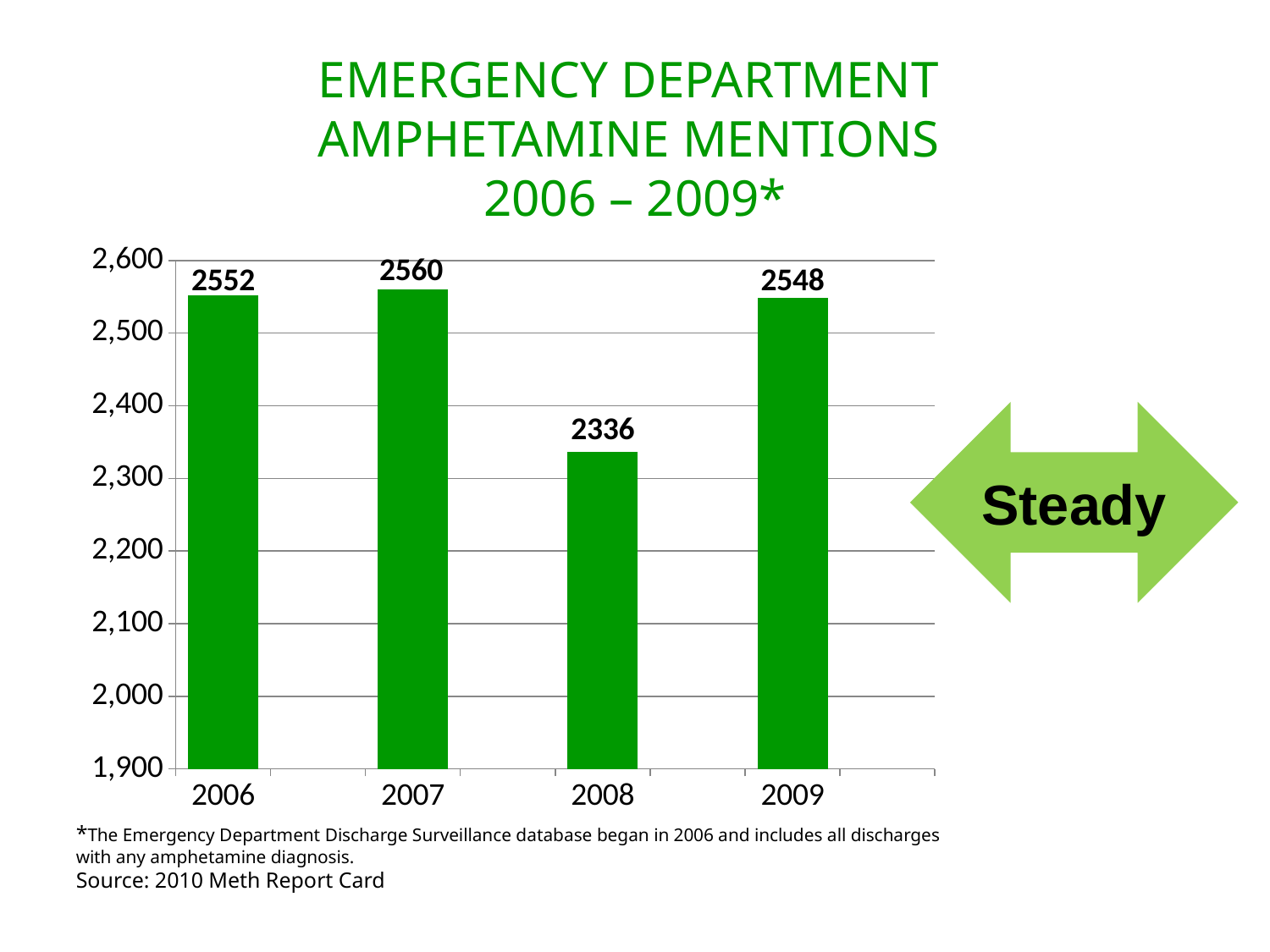
What is the value for 2008? 2336 What kind of chart is this? bar chart What word is written in the arrow to the right of the chart? Steady Which is larger, the value for 2008 or the value for 2009? 2009 What is the value for 2006? 2552 What is the value for 2009? 2548 Is the value for 2008 greater or less than 2,400? less Which year has the highest value? 2007 What is the difference between the values for 2007 and 2008? 224 How many years are shown on the x axis? 4 Which year has the lowest value? 2008 What is the difference between the values for 2006 and 2009? 4